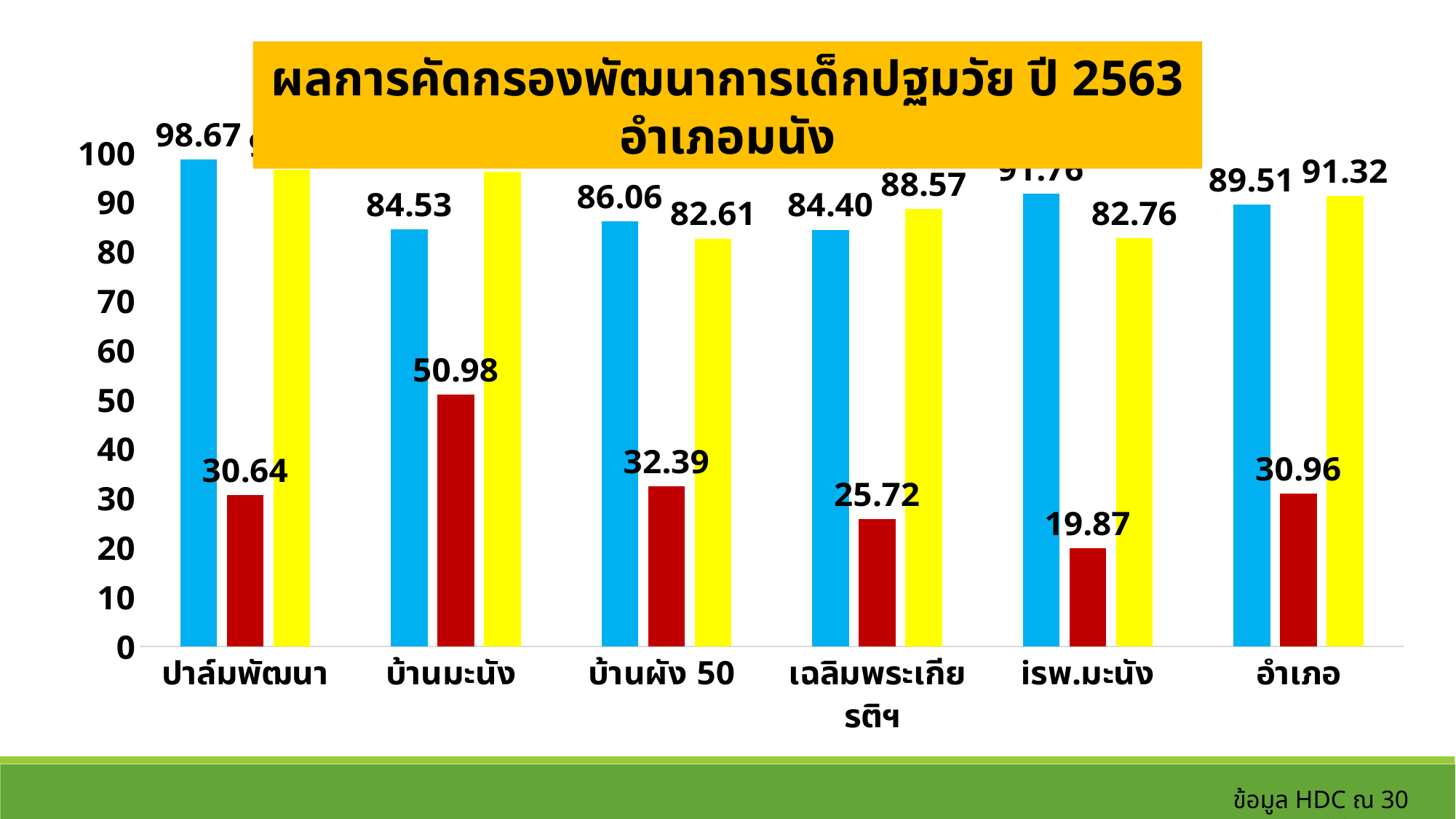
What is the value of the red bar for บ้านมะนัง? 50.98 What is the value of the blue bar for ปาล์มพัฒนา? 98.67 Which category has the lowest red bar? รพ.มะนัง Is the value of the yellow bar for ปาล์มพัฒนา greater or less than 90? greater What is the value of the yellow bar for เฉลิมพระเกียรติฯ? 88.57 Which category has the highest red bar? บ้านมะนัง What is the value of the red bar for รพ.มะนัง? 19.87 What is the difference between the blue bar and the yellow bar for อำเภอ? 1.81 What type of chart is shown on the slide? bar chart Which is larger for บ้านผัง 50, the blue bar or the yellow bar? the blue bar What is the title of the chart? ผลการคัดกรองพัฒนาการเด็กปฐมวัย ปี 2563 อำเภอมนัง How many categories are shown on the x axis of the chart? 6